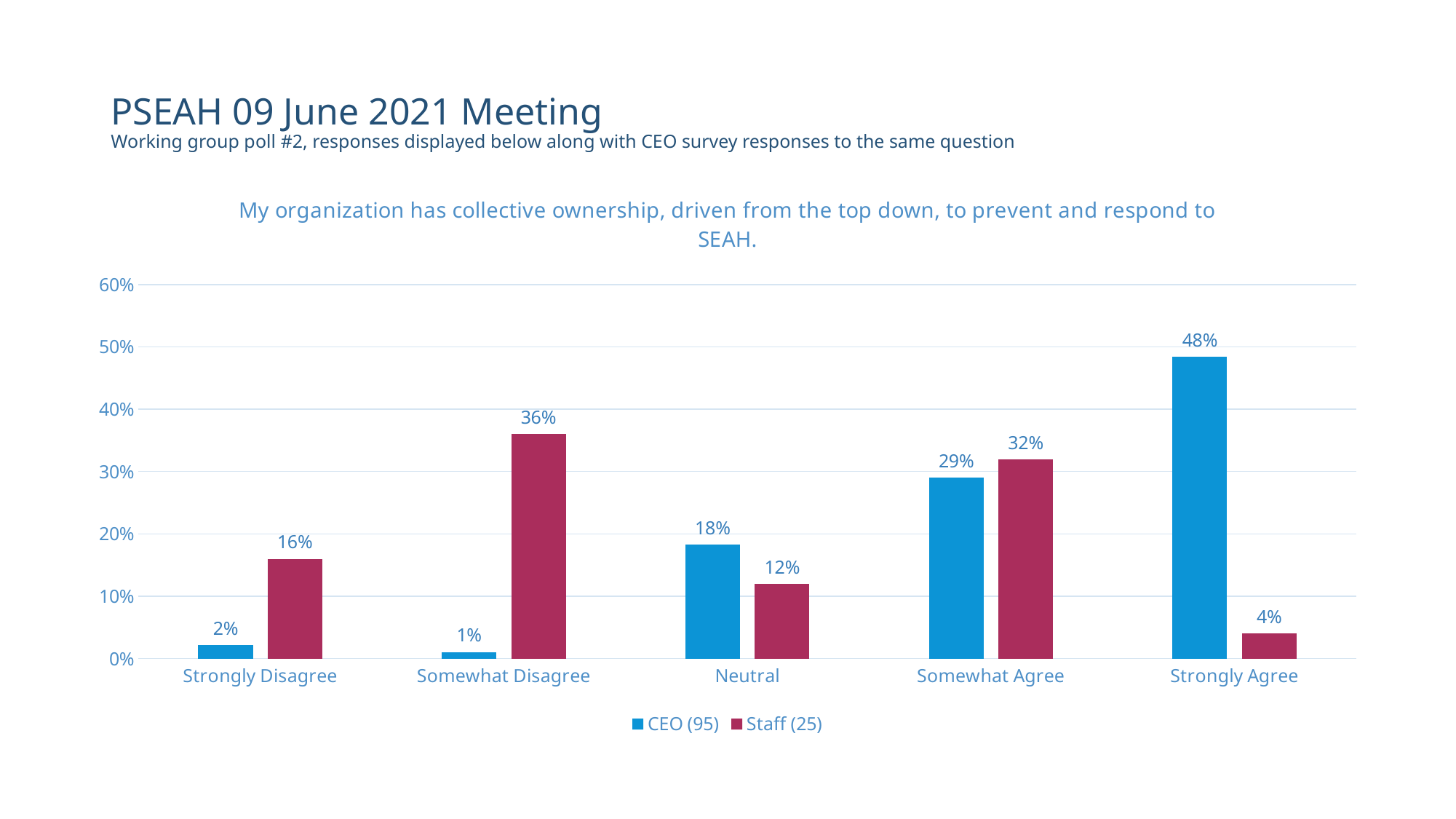
How many response categories are shown on the x axis? 5 What is the difference between the CEO (95) values for Strongly Agree and Somewhat Agree? 19% Which series is shown in blue in the legend? CEO (95) Which category has the highest CEO (95) value? Strongly Agree What is the Staff (25) value for Somewhat Disagree? 36% What is the CEO (95) value for Strongly Agree? 48% For Somewhat Agree, which series has the larger value, CEO (95) or Staff (25)? Staff (25) What is the difference between the Staff (25) and CEO (95) values for Somewhat Disagree? 35% Which category has the lowest Staff (25) value? Strongly Agree How many series does the legend list? 2 What kind of chart is shown on the slide? Bar chart What is the Staff (25) value for Neutral? 12%